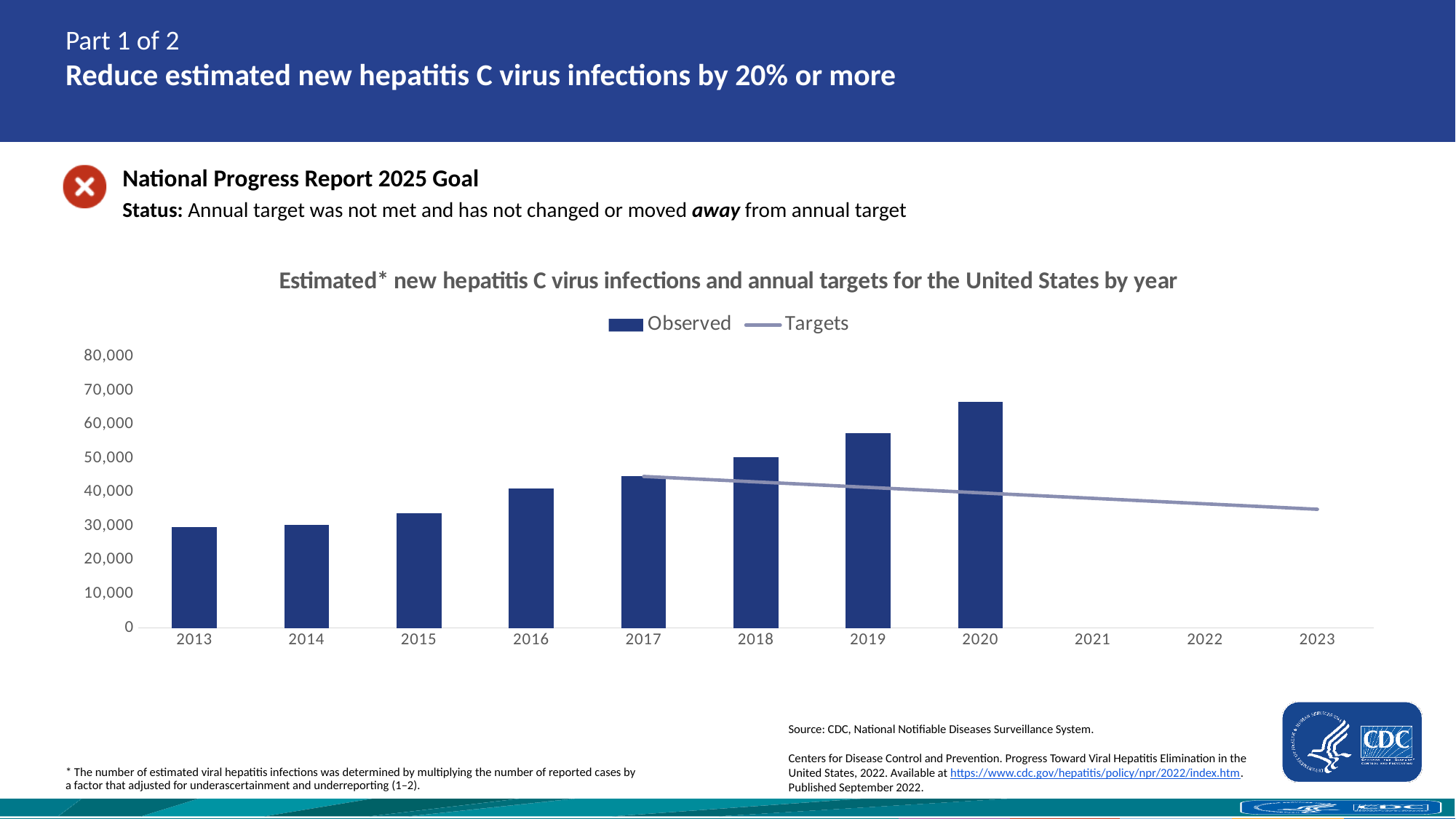
Which year has the highest Observed value? 2020 Is the Observed value for 2015 greater or less than 40,000? less What are the two series named in the chart legend? Observed and Targets Is the Observed value for 2019 greater or less than 50,000? greater Do the Observed values rise or fall from 2013 to 2020? Rise What kind of chart is used to show the observed estimated new hepatitis C virus infections? Bar chart Does the Targets line rise or fall from 2017 to 2023? Fall Which is larger, the Observed value for 2016 or for 2019? 2019 Is the Observed value for 2020 greater or less than 60,000? greater How many years have an Observed bar plotted on the chart? 8 How many series does the chart legend list? 2